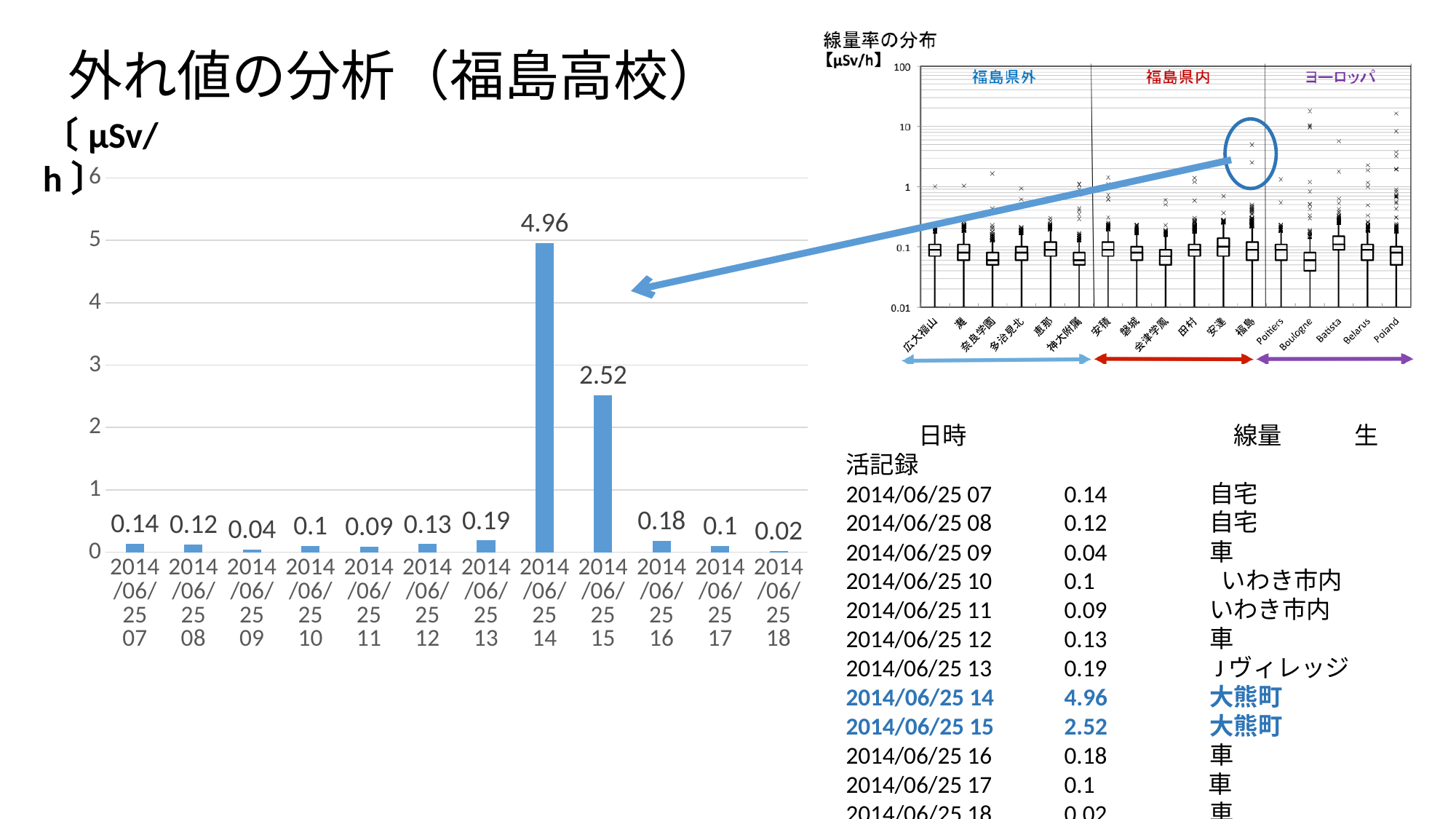
In the bar chart on the left, what is the value for 2014/06/25 09? 0.04 What unit is shown on the vertical axis of the bar chart on the left? μSv/h In the bar chart on the left, what is the value for 2014/06/25 15? 2.52 In the bar chart on the left, is the value for 2014/06/25 14 greater or less than 4? greater In the bar chart on the left, what is the difference between the values for 2014/06/25 14 and 2014/06/25 15? 2.44 In the bar chart on the left, what is the value for 2014/06/25 13? 0.19 In the bar chart on the left, which is larger, the value for 2014/06/25 16 or the value for 2014/06/25 17? 2014/06/25 16 In the bar chart on the left, what is the value for 2014/06/25 14? 4.96 What kind of chart is the chart on the left of the slide? bar chart In the bar chart on the left, which time has the lowest value? 2014/06/25 18 How many bars are plotted in the bar chart on the left? 12 In the bar chart on the left, which time has the highest value? 2014/06/25 14